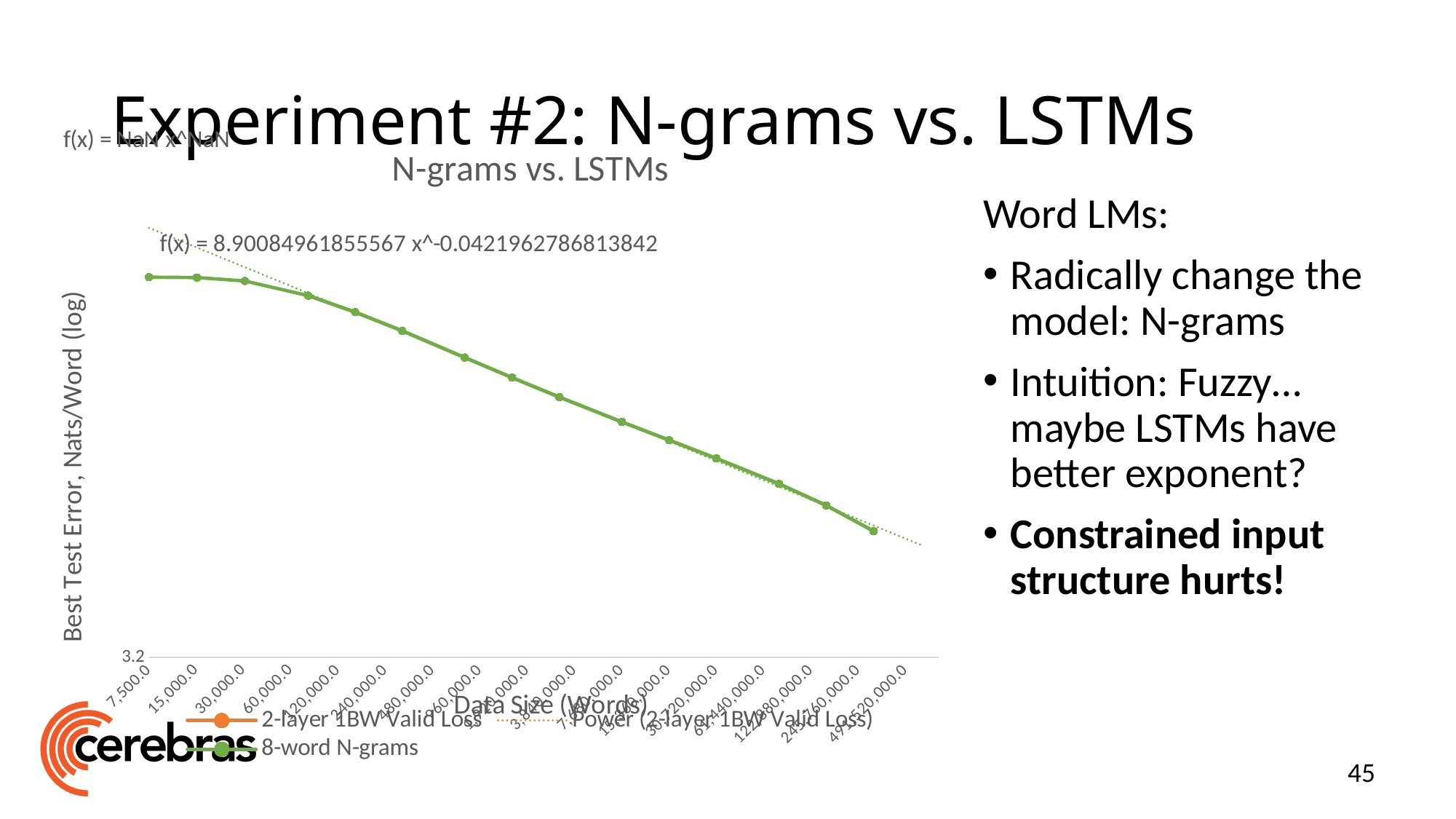
What is the title of the chart? N-grams vs. LSTMs Does the 8-word N-grams line rise or fall as data size increases along the x axis? fall Is the value for 8-word N-grams at the largest data size greater or less than 3.2? greater How many series does the chart legend list? 3 Is the value for 8-word N-grams at 7,500.0 words greater or less than 3.2? greater What is the fitted power-law equation printed on the chart? f(x) = 8.90084961855567 x^-0.0421962786813842 What kind of chart is shown on the slide? line chart